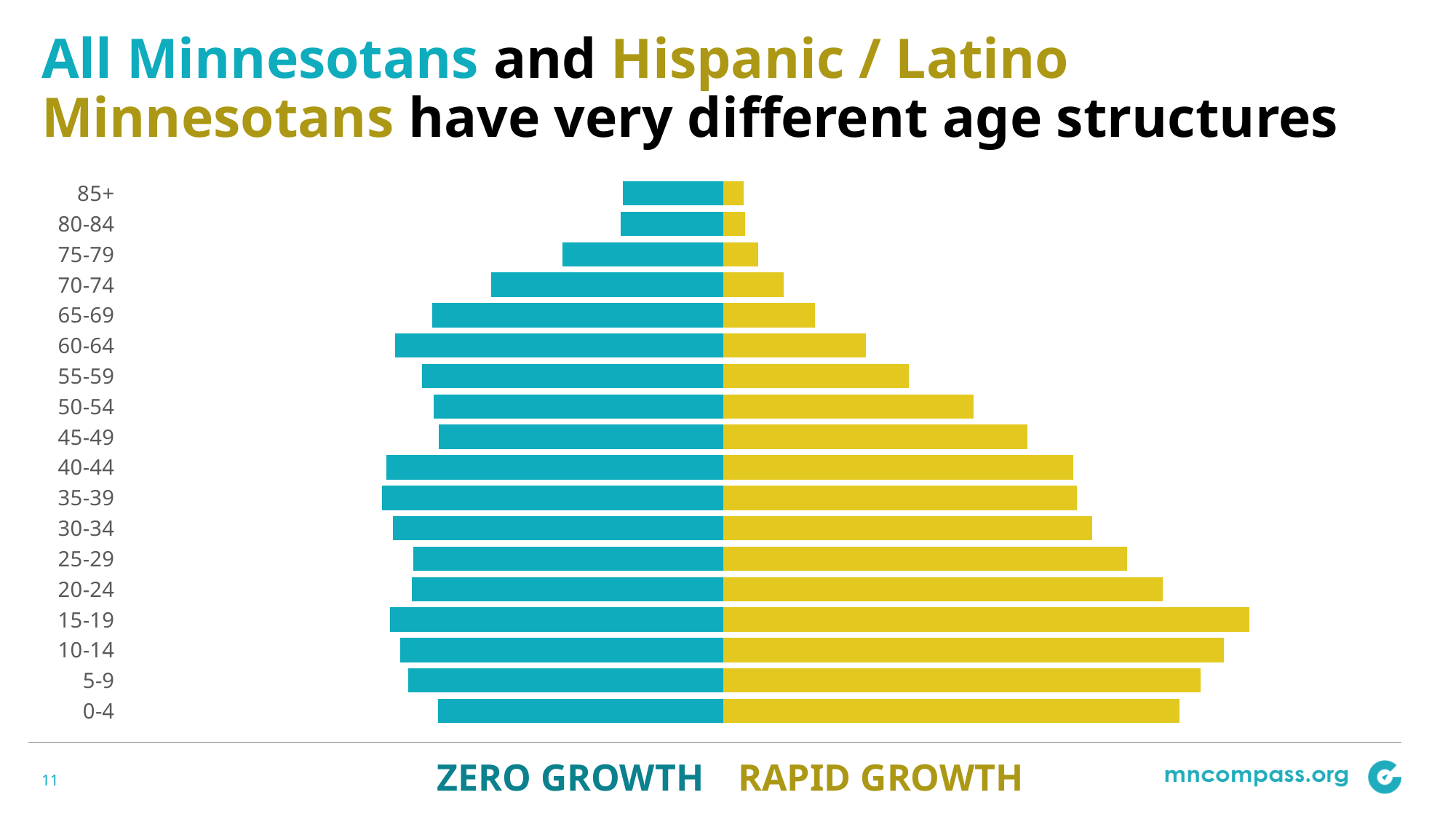
How many data series does the chart show? 2 Which label appears under the Hispanic / Latino Minnesotans side of the chart? RAPID GROWTH For Hispanic / Latino Minnesotans, which is larger: the 15-19 age group or the 65-69 age group? 15-19 Which age group has the largest value for Hispanic / Latino Minnesotans? 15-19 Which colour represents All Minnesotans on the chart? Teal For Hispanic / Latino Minnesotans, do the values rise or fall moving from the 15-19 age group up to the 85+ age group? Fall For Hispanic / Latino Minnesotans, which is larger: the 0-4 age group or the 50-54 age group? 0-4 What kind of chart is shown on the slide? Bar chart For All Minnesotans, which is larger: the 60-64 age group or the 75-79 age group? 60-64 How many age groups are shown on the chart? 18